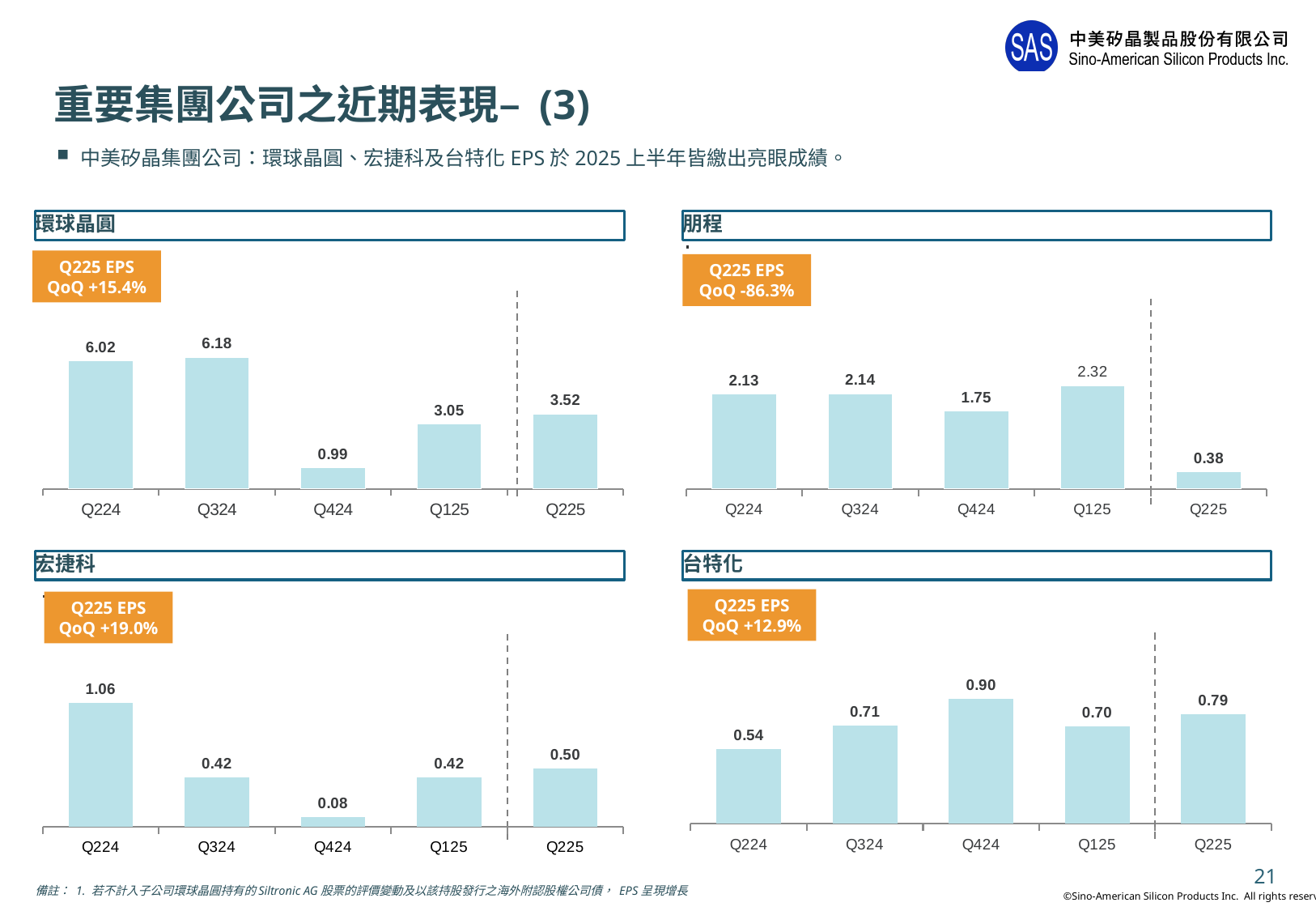
In the 宏捷科 chart, which is larger, the Q125 value or the Q225 value? Q225 How many quarters are shown on the x axis of the 宏捷科 chart? 5 In the 朋程 chart, what is the EPS value for Q125? 2.32 In the 台特化 chart, which quarter has the highest EPS? Q424 In the 環球晶圓 chart, what is the difference between the Q324 and Q424 values? 5.19 In the 朋程 chart, which quarter has the lowest EPS? Q225 In the 環球晶圓 chart, what is the EPS value for Q225? 3.52 In the 環球晶圓 chart, which quarter has the highest EPS? Q324 In the 朋程 chart, what is the difference between the Q125 and Q225 values? 1.94 In the 台特化 chart, what is the difference between the Q225 and Q224 values? 0.25 What type of chart is used for 台特化? Bar chart In the 宏捷科 chart, what is the EPS value for Q424? 0.08